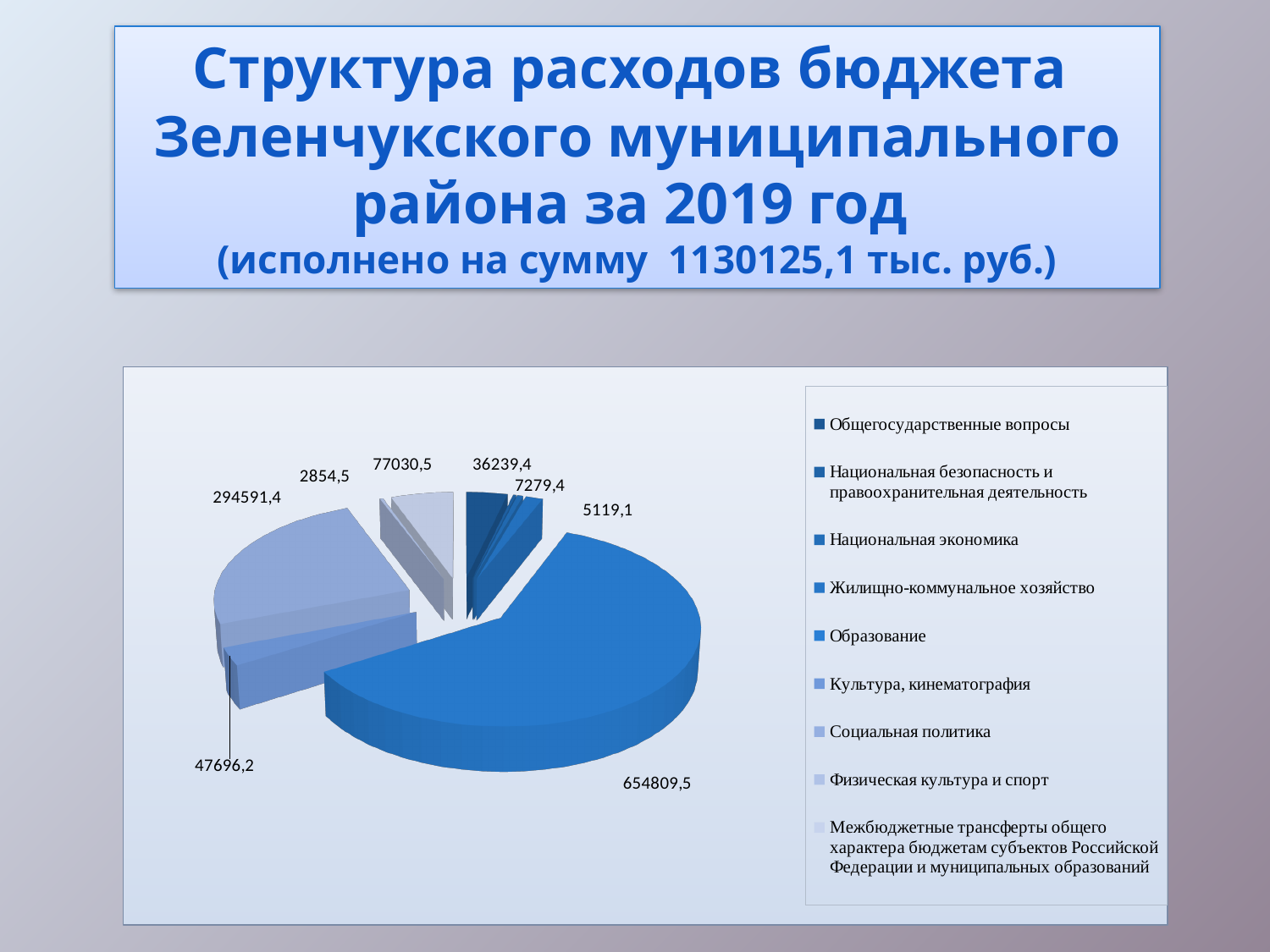
What is the value shown for the largest slice of the pie chart? 654809,5 Which category has the largest slice in the pie chart? Образование Which year does the budget expenditure structure on the slide refer to? 2019 What is the difference between the two largest labelled slices, 654809,5 and 294591,4? 360218,1 What is the value shown for Общегосударственные вопросы in the pie chart? 36239,4 What kind of chart is shown on the slide? pie chart How many categories does the legend of the pie chart list? 9 What is the smallest value printed as a data label on the pie chart? 2854,5 Which is larger: the slice labelled 47696,2 or the slice labelled 77030,5? 77030,5 According to the slide title, what total amount of budget expenditure was executed in 2019? 1130125,1 тыс. руб. What is the value shown for Социальная политика in the pie chart? 294591,4